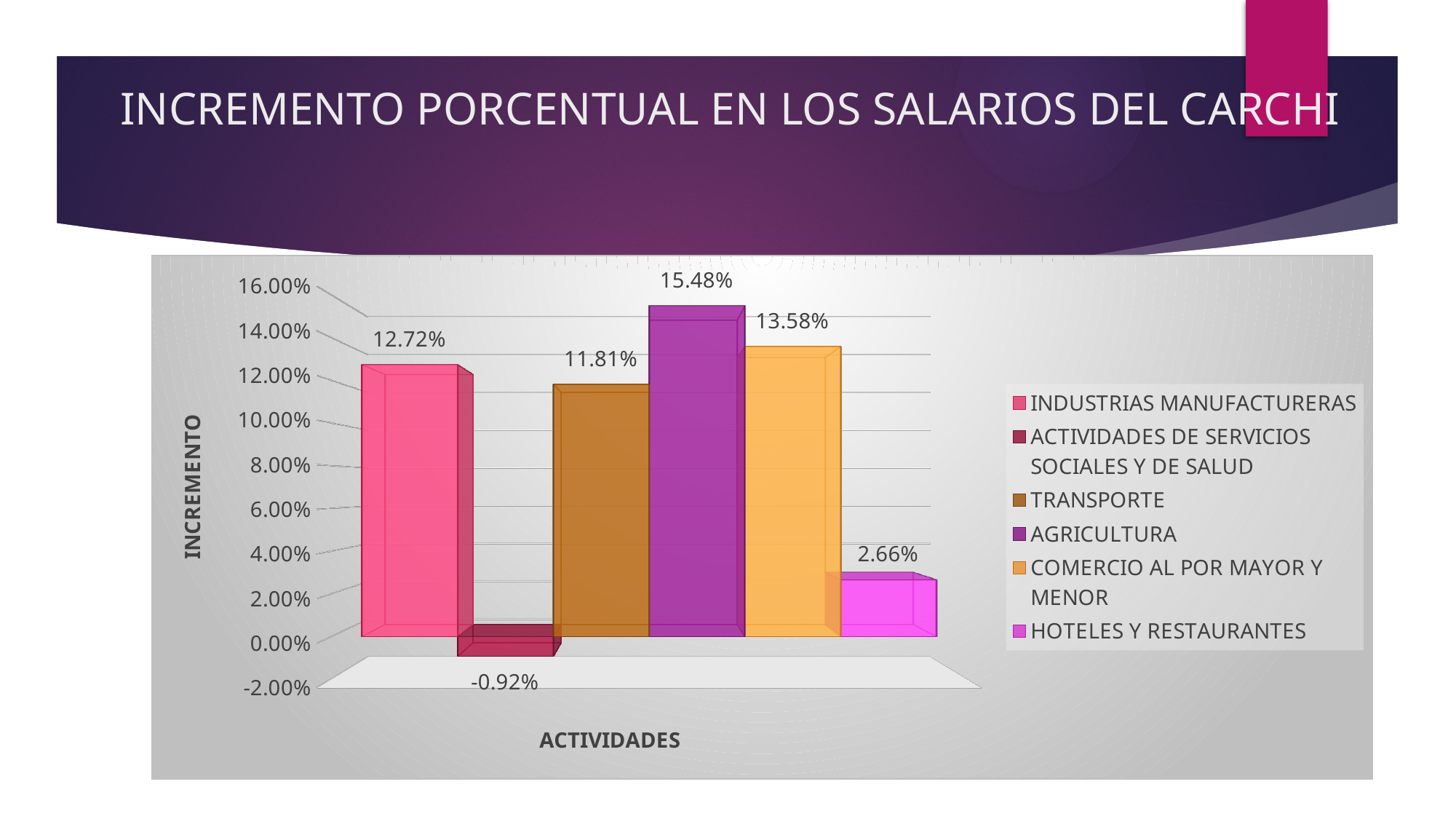
How many series does the legend list? 6 Which activity has the lowest value? ACTIVIDADES DE SERVICIOS SOCIALES Y DE SALUD What is the value for AGRICULTURA? 15.48% What kind of chart is shown on the slide? bar chart Which is larger, the value for COMERCIO AL POR MAYOR Y MENOR or the value for INDUSTRIAS MANUFACTURERAS? COMERCIO AL POR MAYOR Y MENOR Which activity has the highest value? AGRICULTURA What is the value for HOTELES Y RESTAURANTES? 2.66% What is the difference between the values for AGRICULTURA and TRANSPORTE? 3.67% What is the value for ACTIVIDADES DE SERVICIOS SOCIALES Y DE SALUD? -0.92% Is the value for TRANSPORTE greater or less than 10.00%? greater What is the title of the slide? INCREMENTO PORCENTUAL EN LOS SALARIOS DEL CARCHI What is the value for INDUSTRIAS MANUFACTURERAS? 12.72%